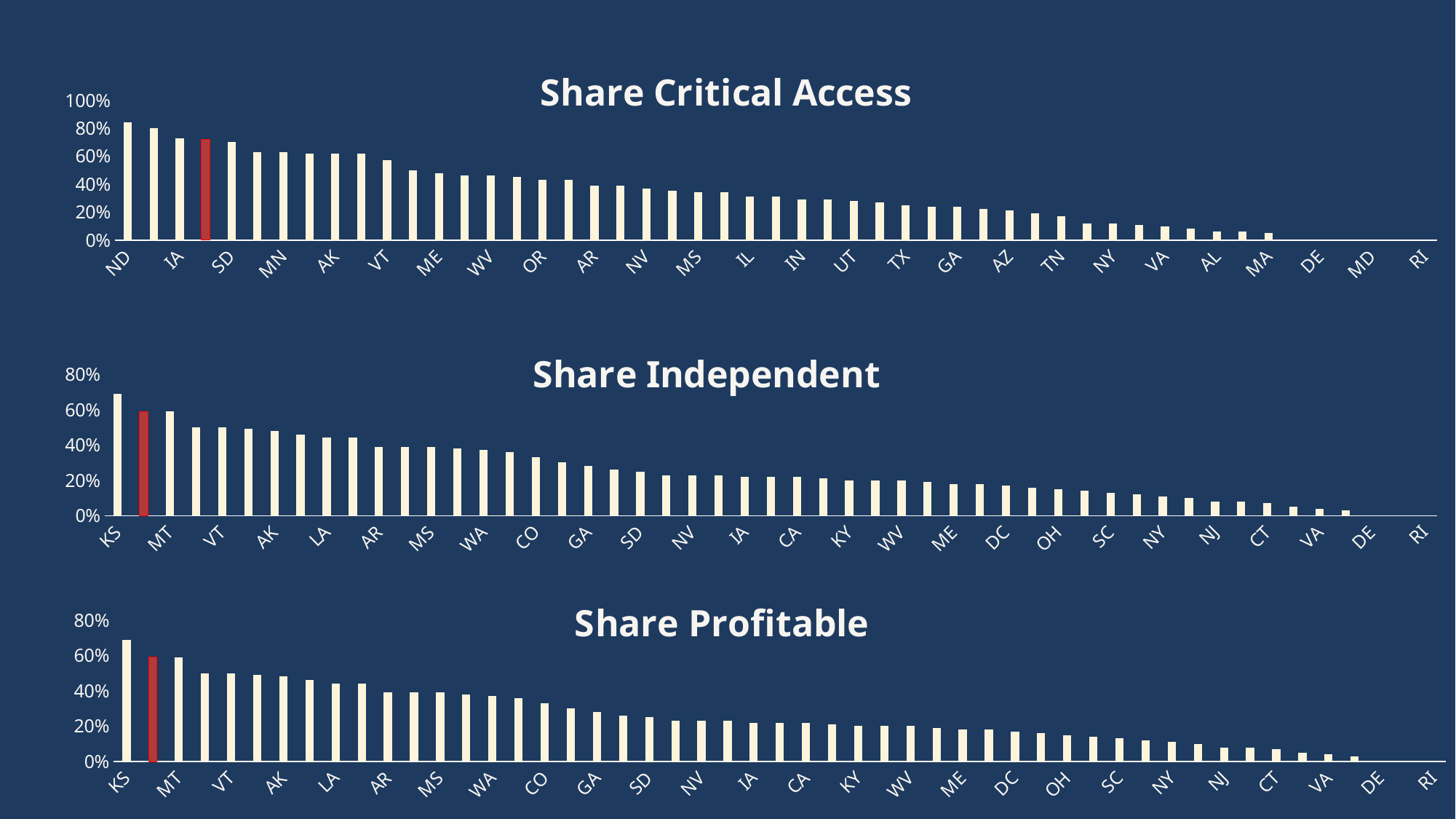
How many charts are shown on the slide? 3 In the 'Share Independent' chart, do the values rise or fall from left to right along the x axis? fall In the 'Share Profitable' chart, which state has the highest value? KS In the 'Share Independent' chart, is the value for KS greater or less than 60%? greater In the 'Share Critical Access' chart, which state has the highest value? ND What kind of chart is the 'Share Critical Access' chart? bar chart In the 'Share Critical Access' chart, is the value for ND greater or less than 80%? greater In the 'Share Profitable' chart, is the value for CO greater or less than 40%? less In the 'Share Critical Access' chart, which is larger, the value for ND or the value for SD? ND In the 'Share Independent' chart, which state has the highest value? KS